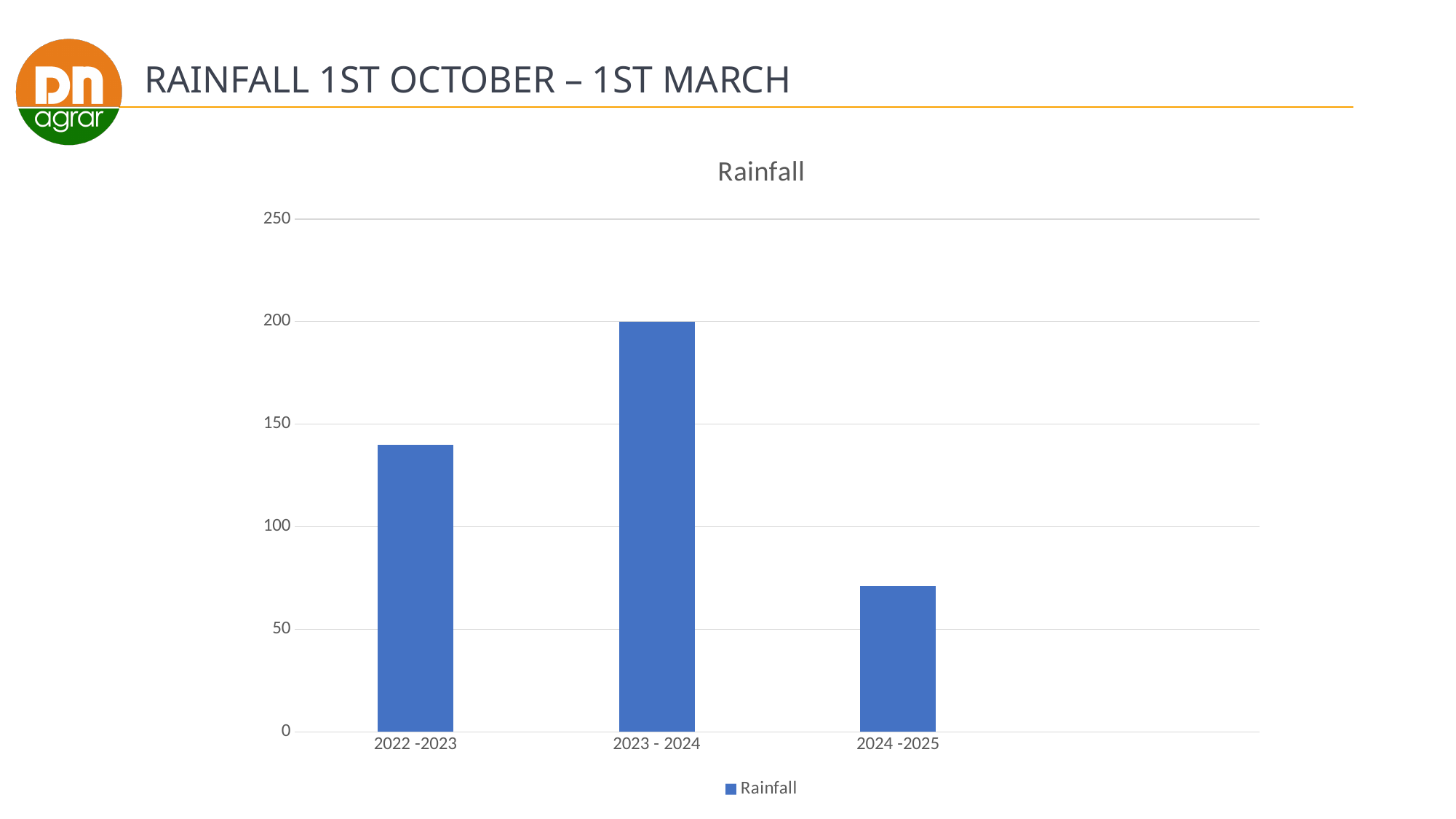
What kind of chart is shown on the slide? bar chart How many categories are shown on the x axis of the chart? 3 How many series does the legend list? 1 Which is larger, the rainfall for 2022 -2023 or for 2024 -2025? 2022 -2023 Is the value for 2024 -2025 greater or less than 100? less What is the title of the chart? Rainfall What is the name of the series shown in the legend? Rainfall Which period has the lowest rainfall? 2024 -2025 Is the value for 2022 -2023 greater or less than 100? greater What is the rainfall value for 2023 - 2024? 200 Is the value for 2022 -2023 greater or less than 150? less Which period has the highest rainfall? 2023 - 2024